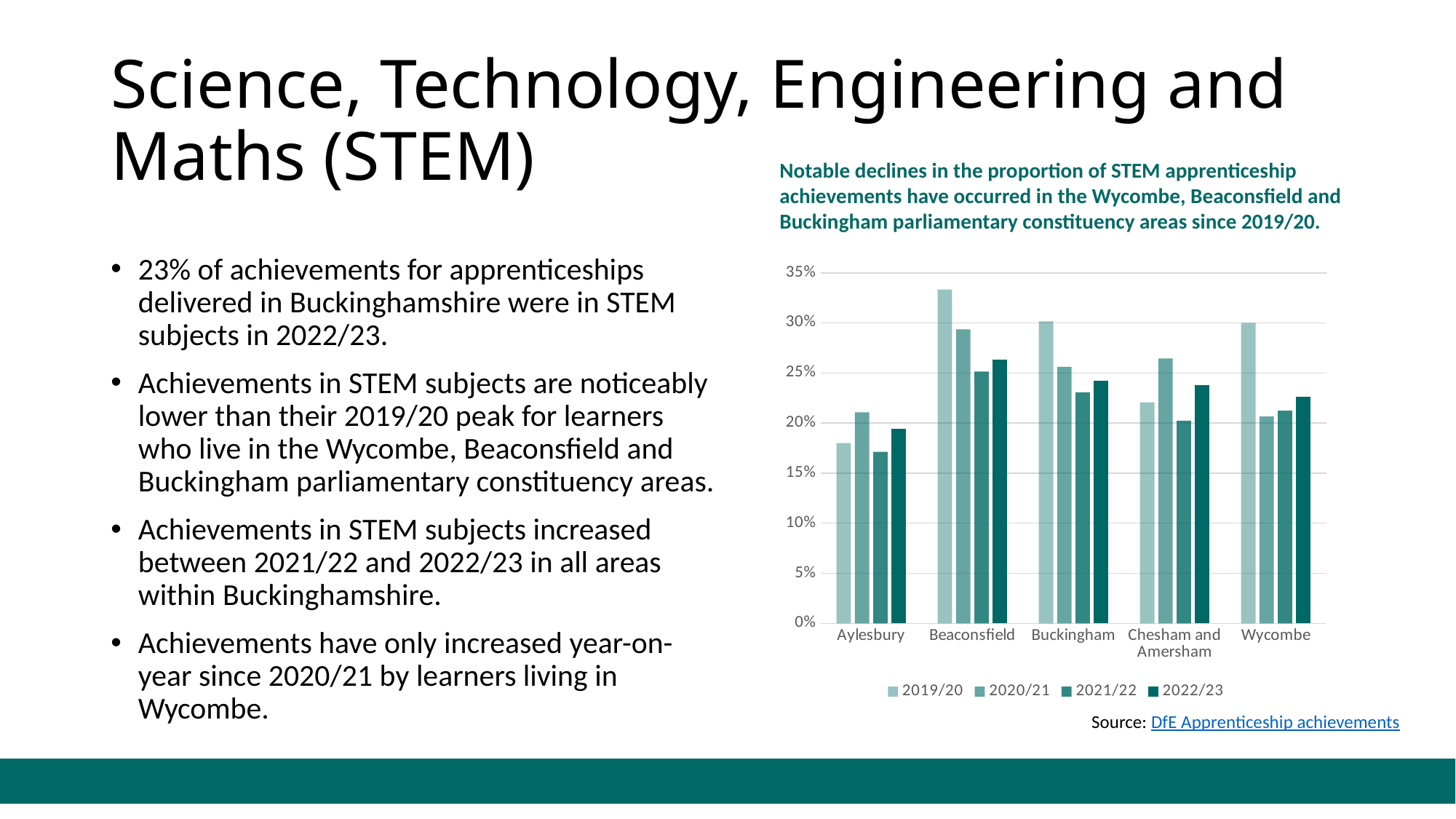
Is the 2019/20 value for Beaconsfield greater or less than 30%? greater Is the 2022/23 value for Wycombe greater or less than 25%? less How many series does the chart's legend list? 4 For Chesham and Amersham, which is larger: the 2019/20 value or the 2020/21 value? 2020/21 What kind of chart is shown on the slide? bar chart How many parliamentary constituency areas are shown on the x axis of the chart? 5 Is the 2021/22 value for Aylesbury greater or less than 20%? less For Wycombe, which is larger: the 2019/20 value or the 2020/21 value? 2019/20 Which constituency has the lowest value for 2021/22? Aylesbury Which constituency has the highest value for 2019/20? Beaconsfield What is the first series listed in the chart's legend? 2019/20